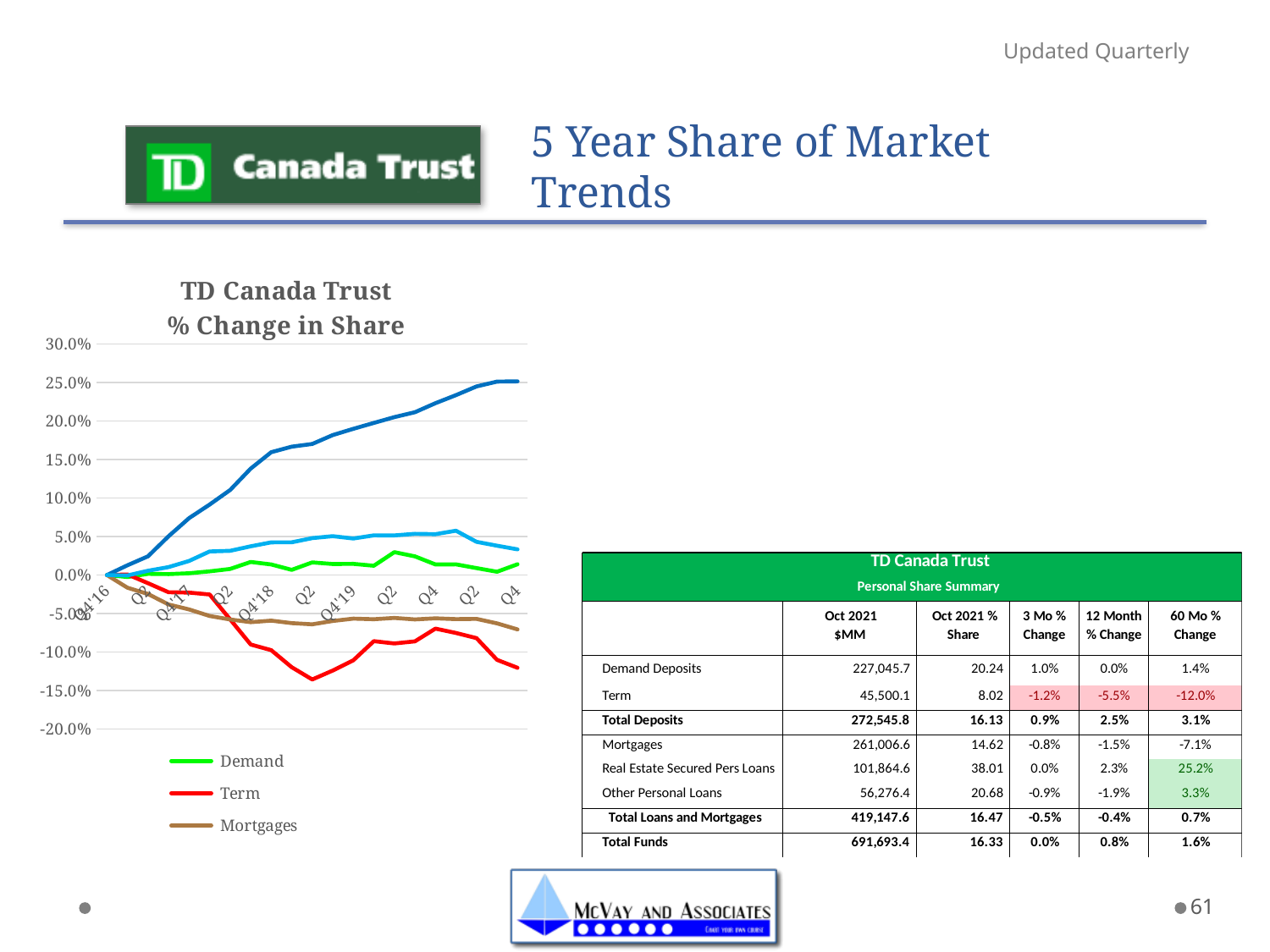
What colour is the Term line in the "% Change in Share" chart? red In the "% Change in Share" chart, is the lowest point of the Term line greater or less than -10.0%? less How many series does the legend of the "% Change in Share" chart list? 3 In the "% Change in Share" chart, which of the legend series has the lowest value at the last point (Q4)? Term In the "% Change in Share" chart, does the Term line generally rise or fall from Q4'16 to the final Q4? fall In the "% Change in Share" chart, does the Mortgages line generally rise or fall from Q4'16 to the final Q4? fall In the "% Change in Share" chart, is the value for Mortgages at the last point (Q4) greater or less than -5.0%? less Which series are listed in the legend of the "% Change in Share" chart? Demand, Term, Mortgages In the "% Change in Share" chart, which is larger at the last point (Q4): Demand or Term? Demand In the "% Change in Share" chart, is the value for Demand at the last point (Q4) greater or less than -5.0%? greater What kind of chart is the "TD Canada Trust % Change in Share" chart? line chart